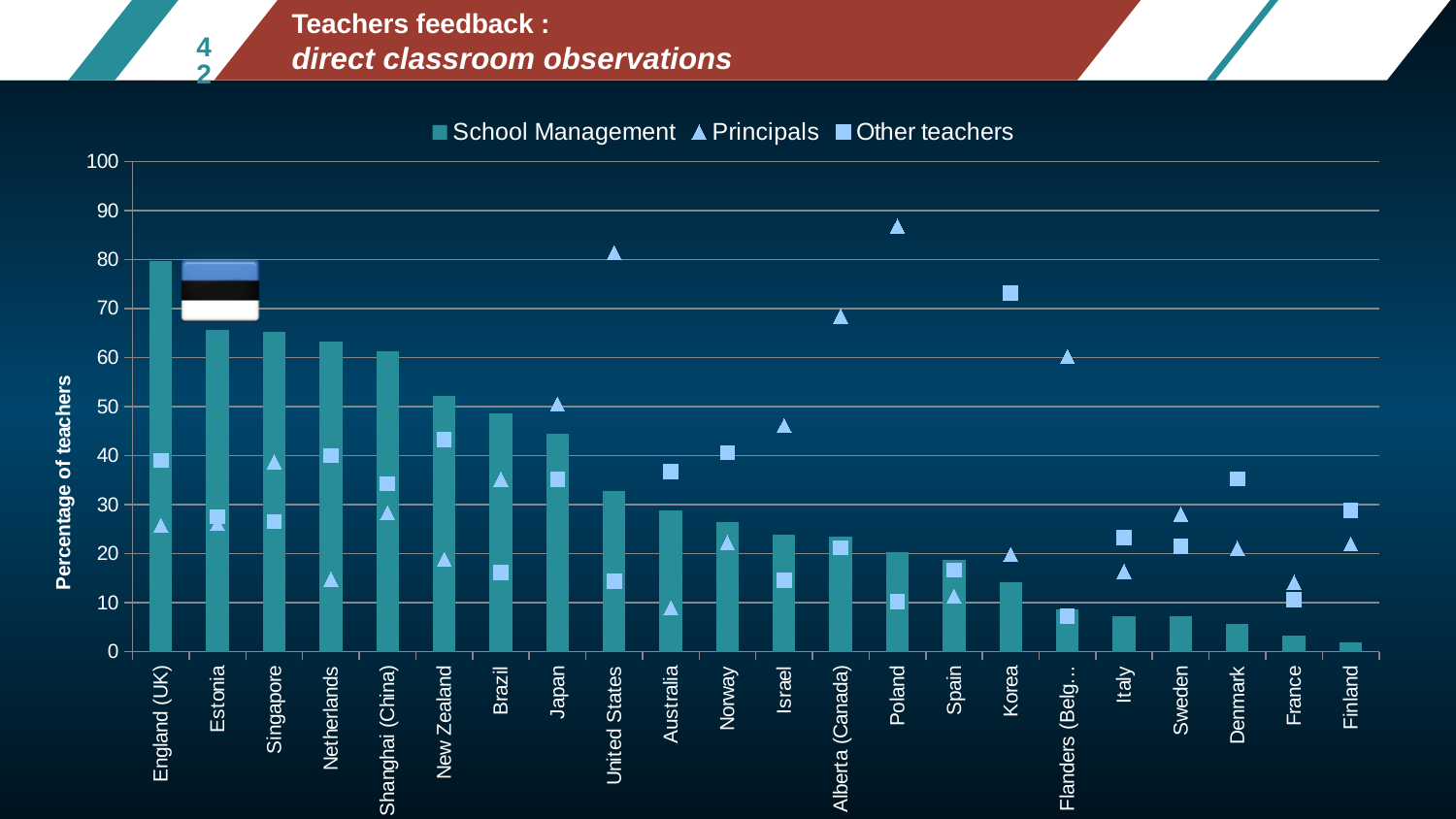
Which country has the highest School Management value? England (UK) For Japan, which is larger: the Principals value or the Other teachers value? Principals Is the Principals value for Poland greater or less than 80? greater Is the School Management value for Finland greater or less than 10? less Is the School Management value for England (UK) greater or less than 70? greater Which country has the highest Principals value? Poland How many countries or regions are shown on the x axis? 22 What kind of chart is shown on the slide? bar chart (with line markers) Do the School Management bars rise or fall from left to right along the x axis? fall Which country has the lowest School Management value? Finland How many series does the legend list? 3